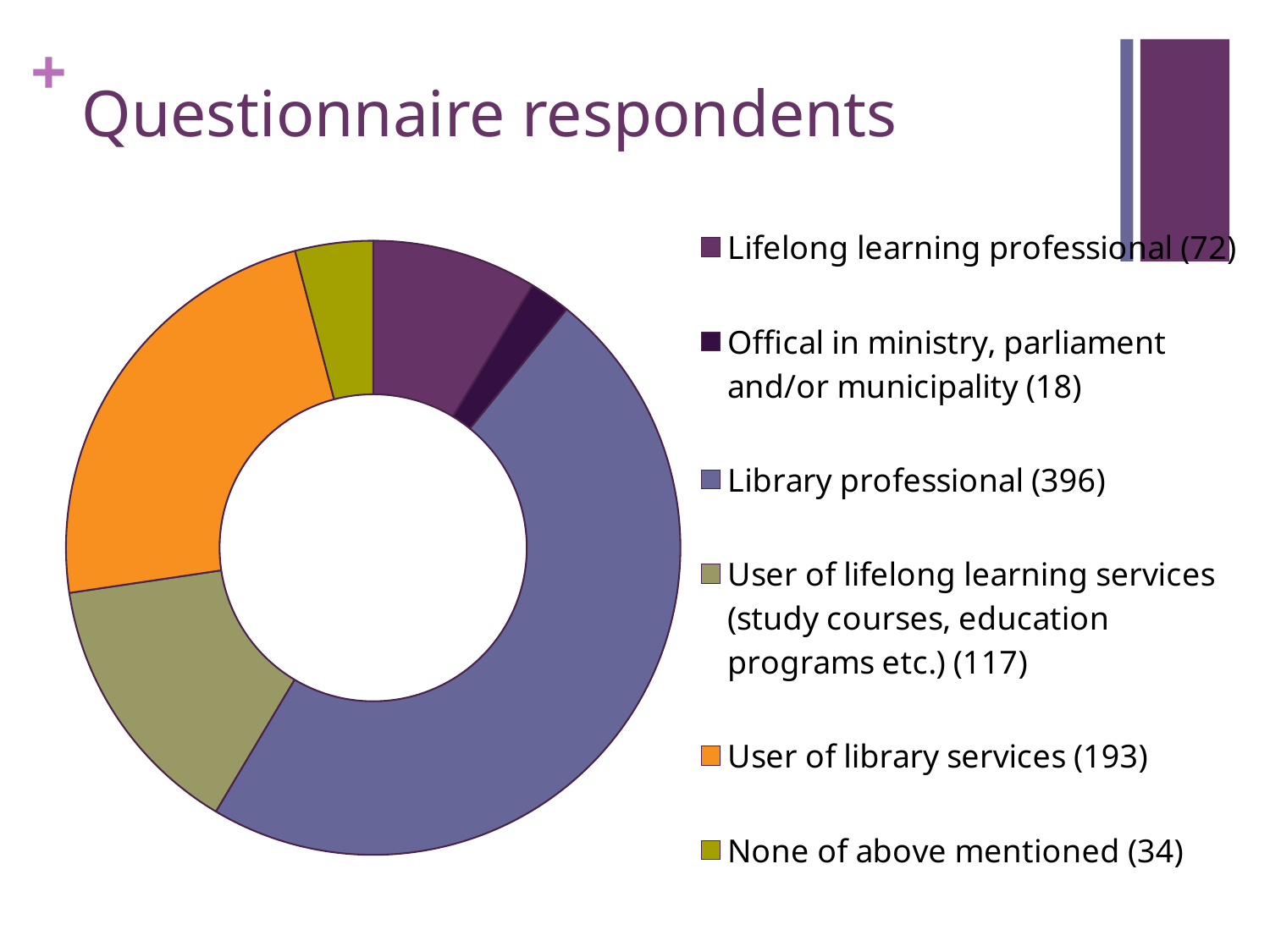
How many more users of library services than users of lifelong learning services responded? 76 Which group had more respondents: lifelong learning professionals or users of lifelong learning services? User of lifelong learning services How many respondents were library professionals? 396 What is the title of the slide containing the chart? Questionnaire respondents How many respondents chose 'None of above mentioned'? 34 What is the total number of questionnaire respondents across all categories? 830 Which respondent group has the smallest number of respondents? Offical in ministry, parliament and/or municipality How many respondents were users of library services? 193 Which respondent group has the largest number of respondents? Library professional How many respondents were officials in ministry, parliament and/or municipality? 18 How many respondent categories does the chart show? 6 What kind of chart is shown on the slide? doughnut chart